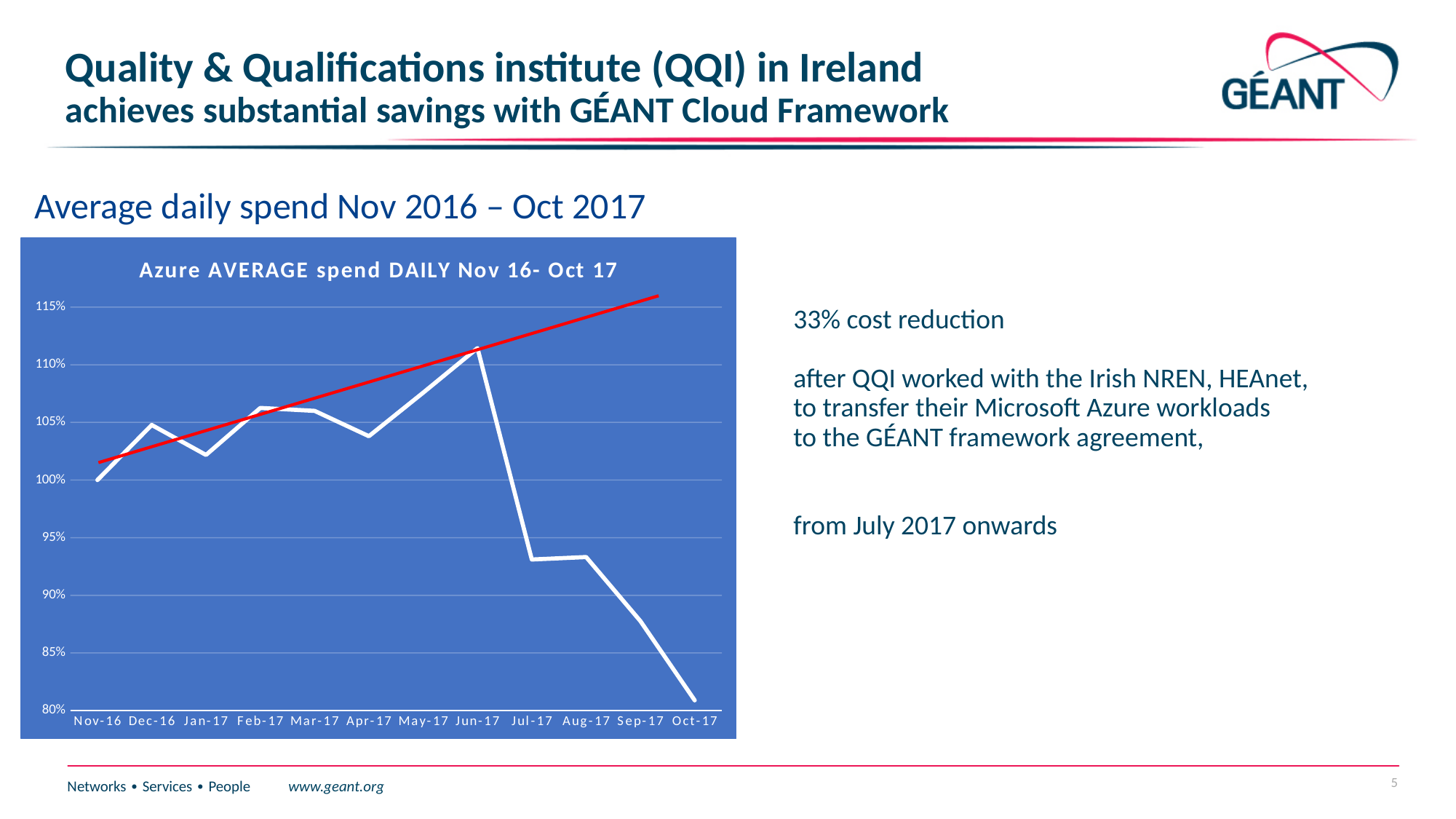
Which month has the lowest average daily spend in the chart? Oct-17 Is the value for Oct-17 greater or less than 85%? less How many months are plotted along the x axis of the chart? 12 What is the title of the chart? Azure AVERAGE spend DAILY Nov 16- Oct 17 Which is larger, the value for Jun-17 or the value for Oct-17? Jun-17 How does the average daily spend change from Jun-17 to Oct-17? it falls Is the value for Jun-17 greater or less than 105%? greater What kind of chart is shown on the slide? line chart Which month has the highest average daily spend in the chart? Jun-17 Is the value for Dec-16 greater or less than 100%? greater